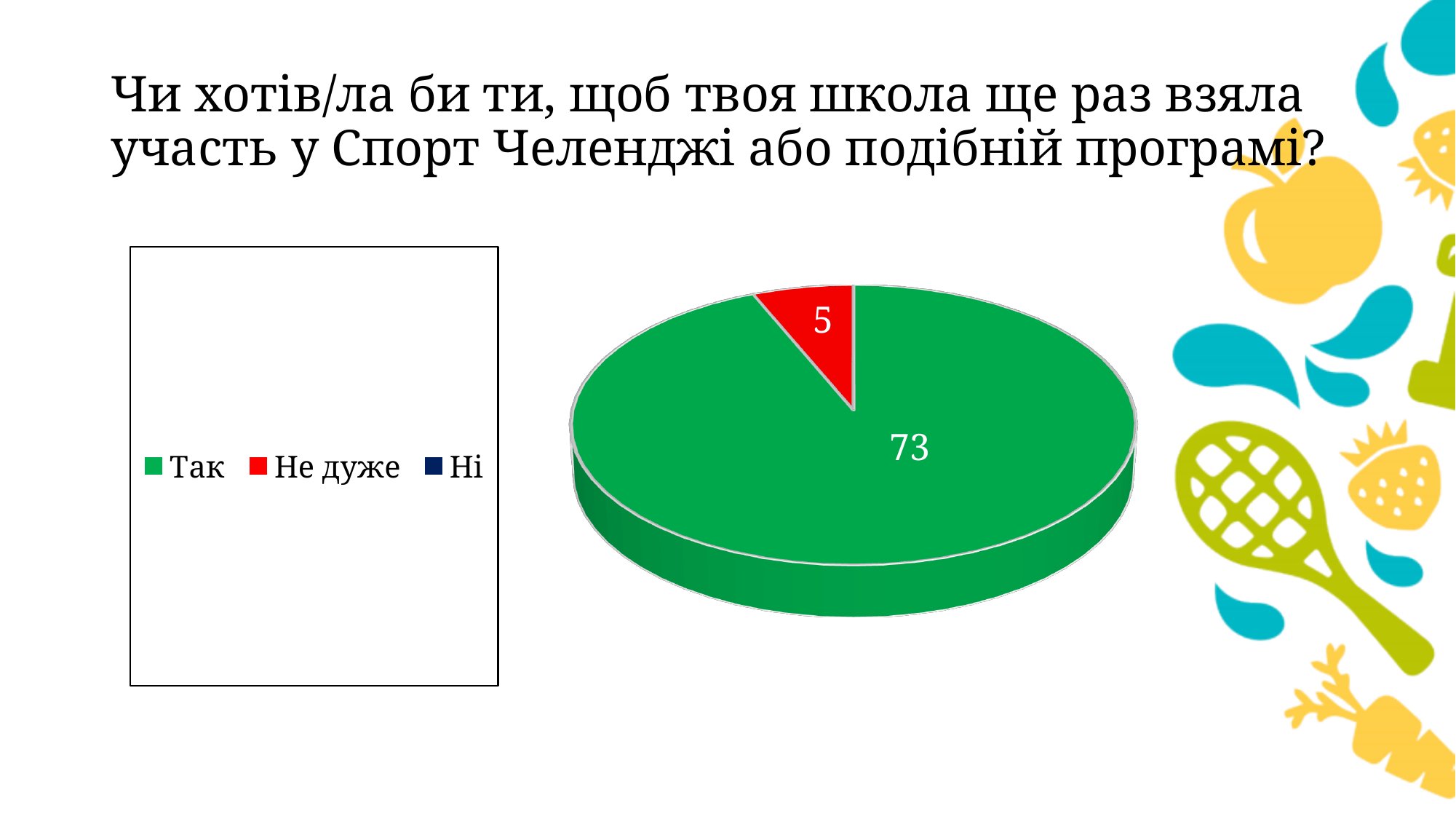
How many categories does the legend list? 3 How many slices in the pie chart have a printed data label? 2 What colour represents "Не дуже" in the pie chart? Red Which is larger, the "Так" slice or the "Не дуже" slice? Так Which category has the largest slice in the pie chart? Так What value is shown for the "Не дуже" slice of the pie chart? 5 What colour represents "Так" in the pie chart? Green What kind of chart is shown on the slide? Pie chart What is the difference between the values for "Так" and "Не дуже"? 68 What value is shown for the "Так" slice of the pie chart? 73